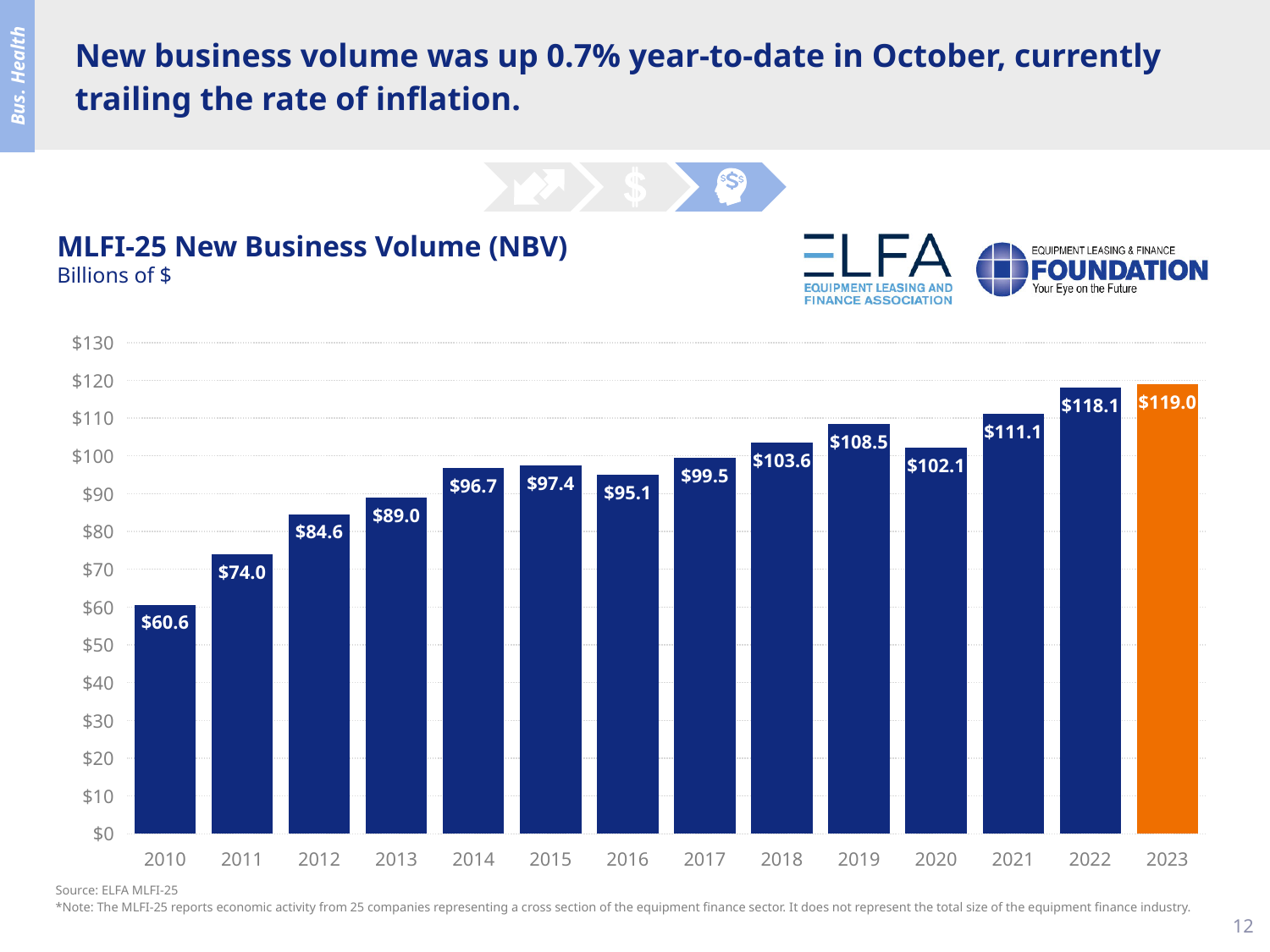
Which year's bar is shown in orange rather than dark blue? 2023 Do the values generally rise or fall from 2010 to 2023? Rise What is the MLFI-25 new business volume for 2020? $102.1 What is the difference between the new business volume in 2022 and 2021? $7.0 How many years are shown on the chart? 14 Which year has the highest new business volume? 2023 Which year has a larger new business volume, 2019 or 2020? 2019 What is the MLFI-25 new business volume for 2016? $95.1 Which year has the lowest new business volume? 2010 What is the MLFI-25 new business volume for 2010? $60.6 Is the value for 2013 greater or less than $90? less What kind of chart is shown on the slide? Bar chart